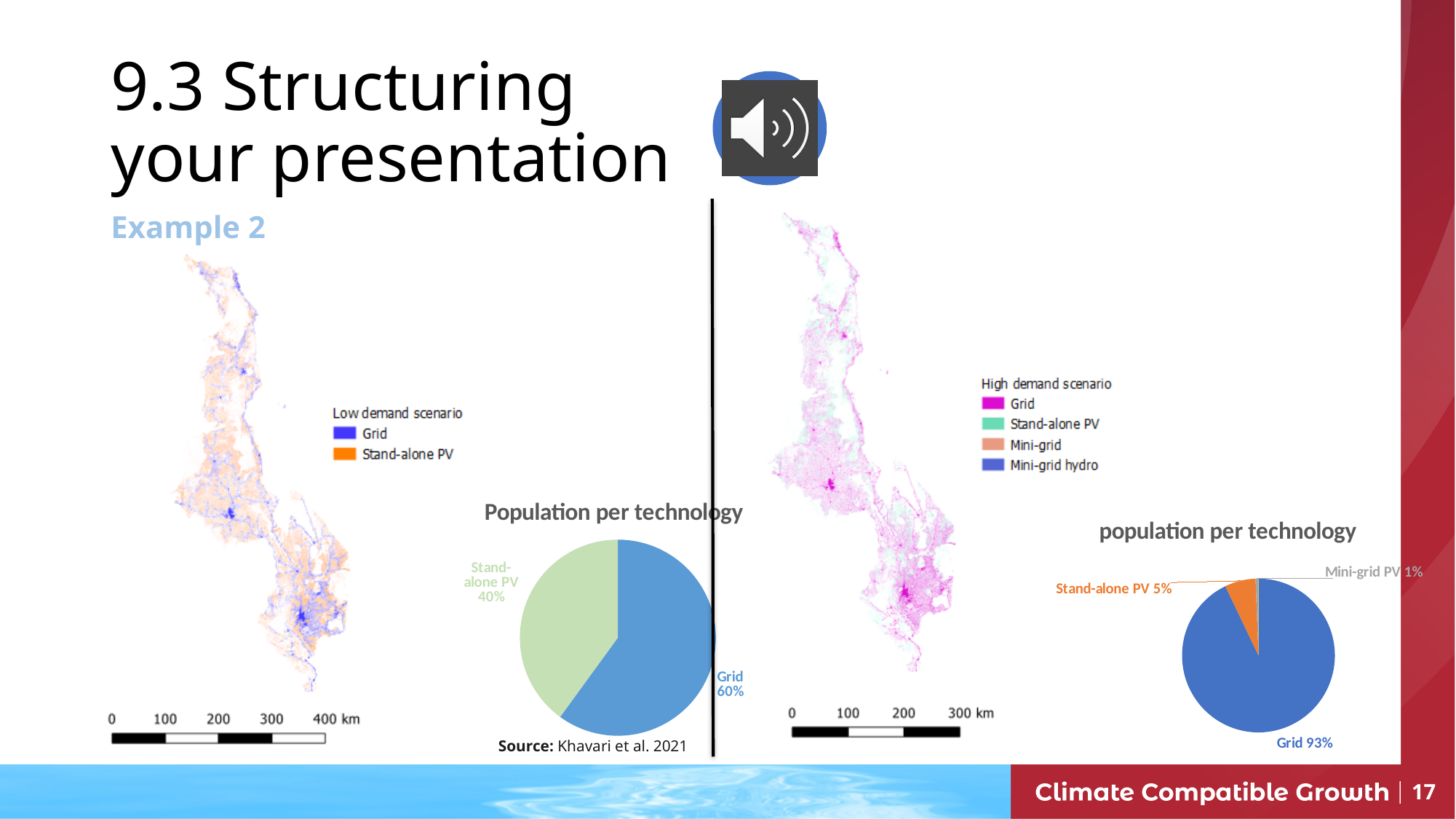
In the right pie chart titled 'population per technology', what share does Stand-alone PV have? 5% In the left pie chart titled 'Population per technology', what is the difference in percentage points between Grid and Stand-alone PV? 20 percentage points In the right pie chart titled 'population per technology', what share does Mini-grid PV have? 1% In the right pie chart titled 'population per technology', which is larger: Stand-alone PV or Mini-grid PV? Stand-alone PV In the left pie chart titled 'Population per technology', which technology has the largest share? Grid How many slices does the left pie chart titled 'Population per technology' have? 2 In the left pie chart titled 'Population per technology', what share does Grid have? 60% In the right pie chart titled 'population per technology', what share does Grid have? 93% What type of chart is the left chart titled 'Population per technology'? Pie chart In the right pie chart titled 'population per technology', which labelled technology has the smallest share? Mini-grid PV In the right pie chart titled 'population per technology', what is the difference in percentage points between Grid and Stand-alone PV? 88 percentage points In the left pie chart titled 'Population per technology', what share does Stand-alone PV have? 40%